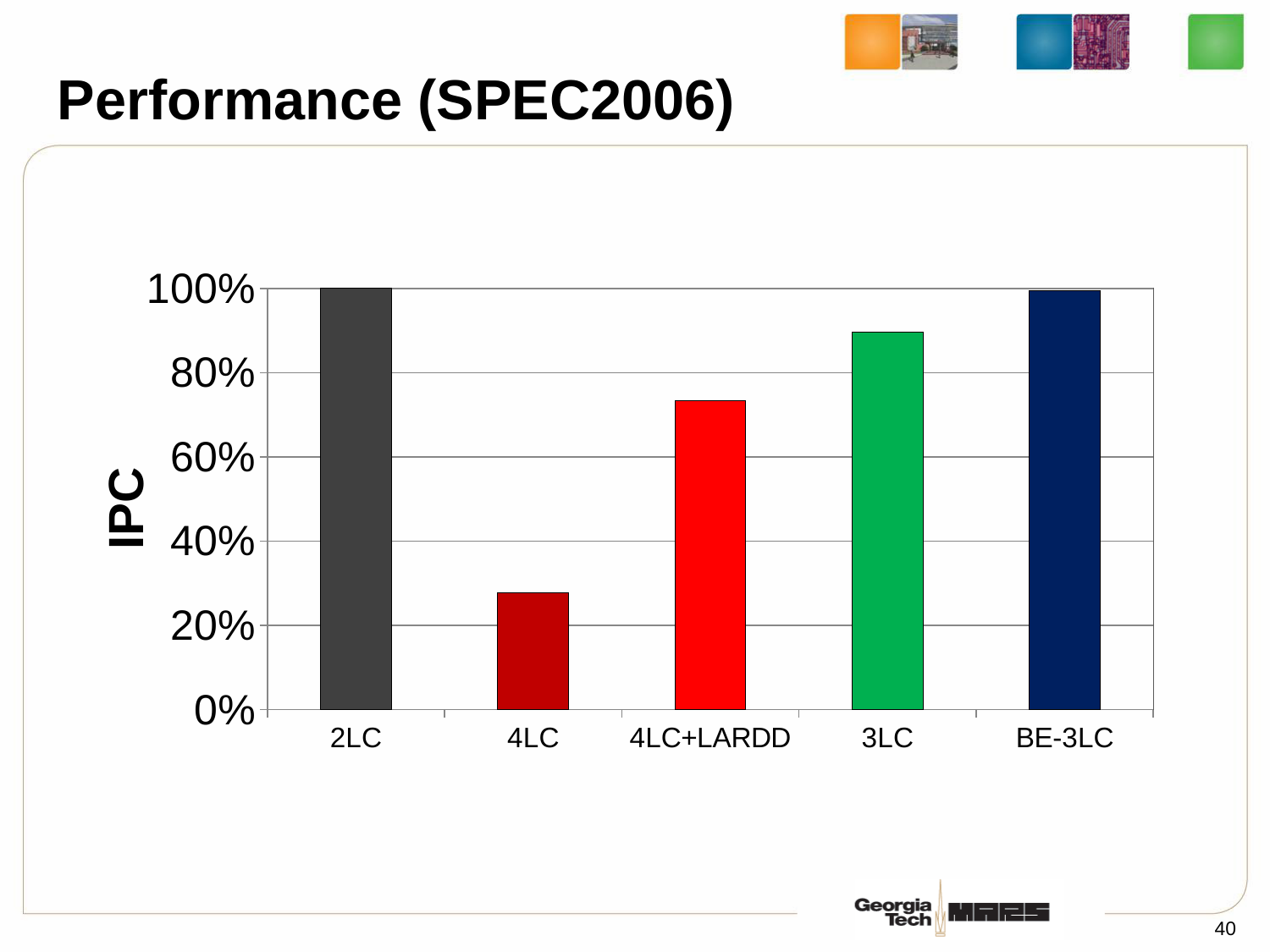
Is the value for 4LC greater or less than 20%? greater What kind of chart is shown on the slide? bar chart Is the value for 3LC greater or less than 80%? greater Is the value for 4LC+LARDD greater or less than 60%? greater How many categories are plotted on the x axis? 5 What is the label on the y axis of the chart? IPC Which has a higher IPC, 4LC or 4LC+LARDD? 4LC+LARDD Which category has the lowest IPC? 4LC What is the IPC value for 2LC? 100% Which has a higher IPC, 3LC or 4LC+LARDD? 3LC